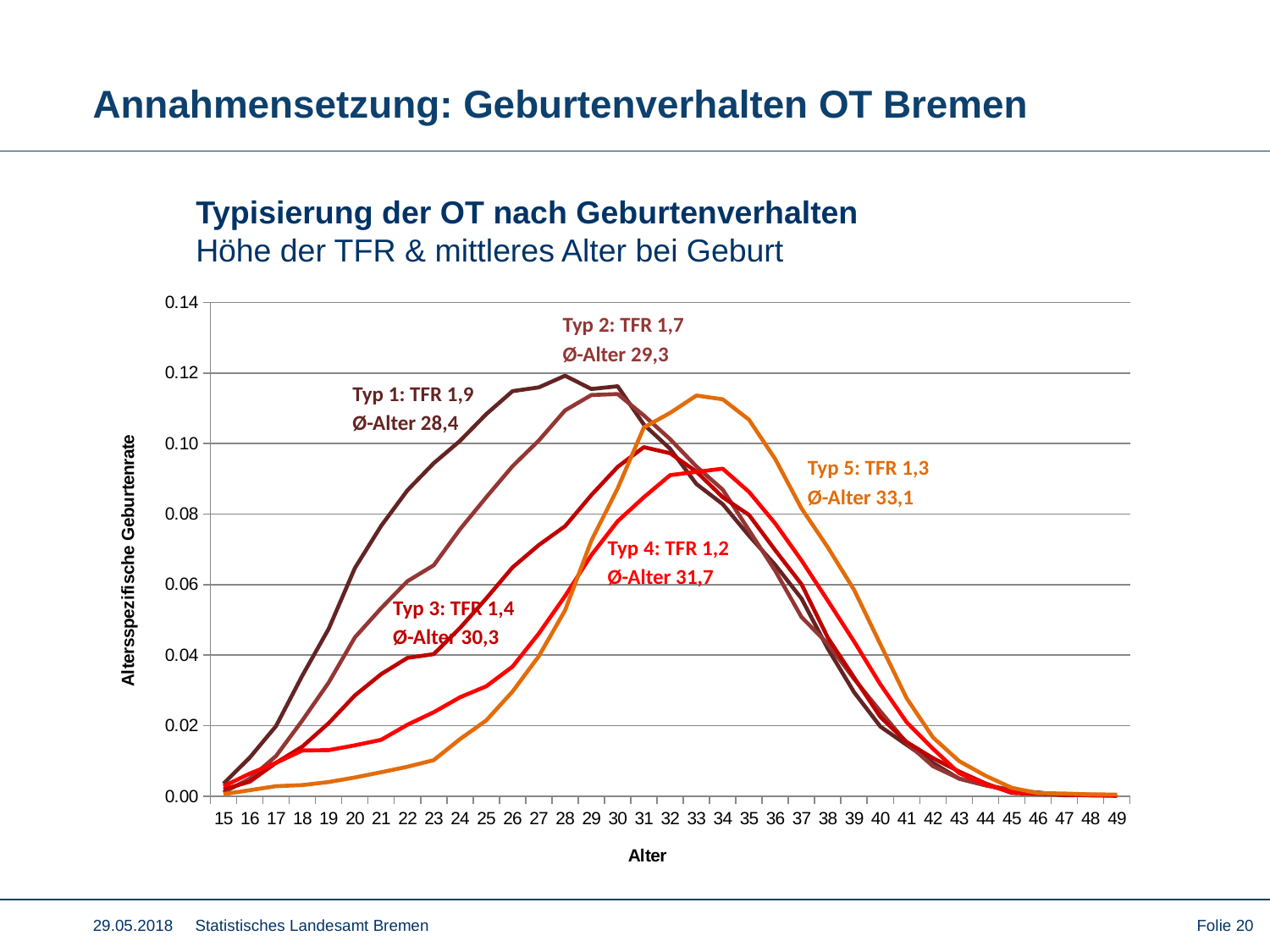
What is the label of the y axis of the chart? Altersspezifische Geburtenrate What kind of chart is shown on the slide? Line chart Is the value of the Typ 5 curve at age 20 greater or less than 0.02? less What TFR value is given for Typ 5 in the chart? 1,3 What Ø-Alter is given for Typ 2 in the chart? 29,3 How many types (series) are plotted in the chart? 5 Which has the higher Ø-Alter, Typ 3 or Typ 5? Typ 5 How many ages are shown along the x axis of the chart? 35 What is the difference between the TFR of Typ 1 and the TFR of Typ 4? 0,7 Which type has the lowest TFR according to the chart annotations? Typ 4 Which type has the highest TFR according to the chart annotations? Typ 1 Is the value of the Typ 1 curve at age 28 greater or less than 0.10? greater